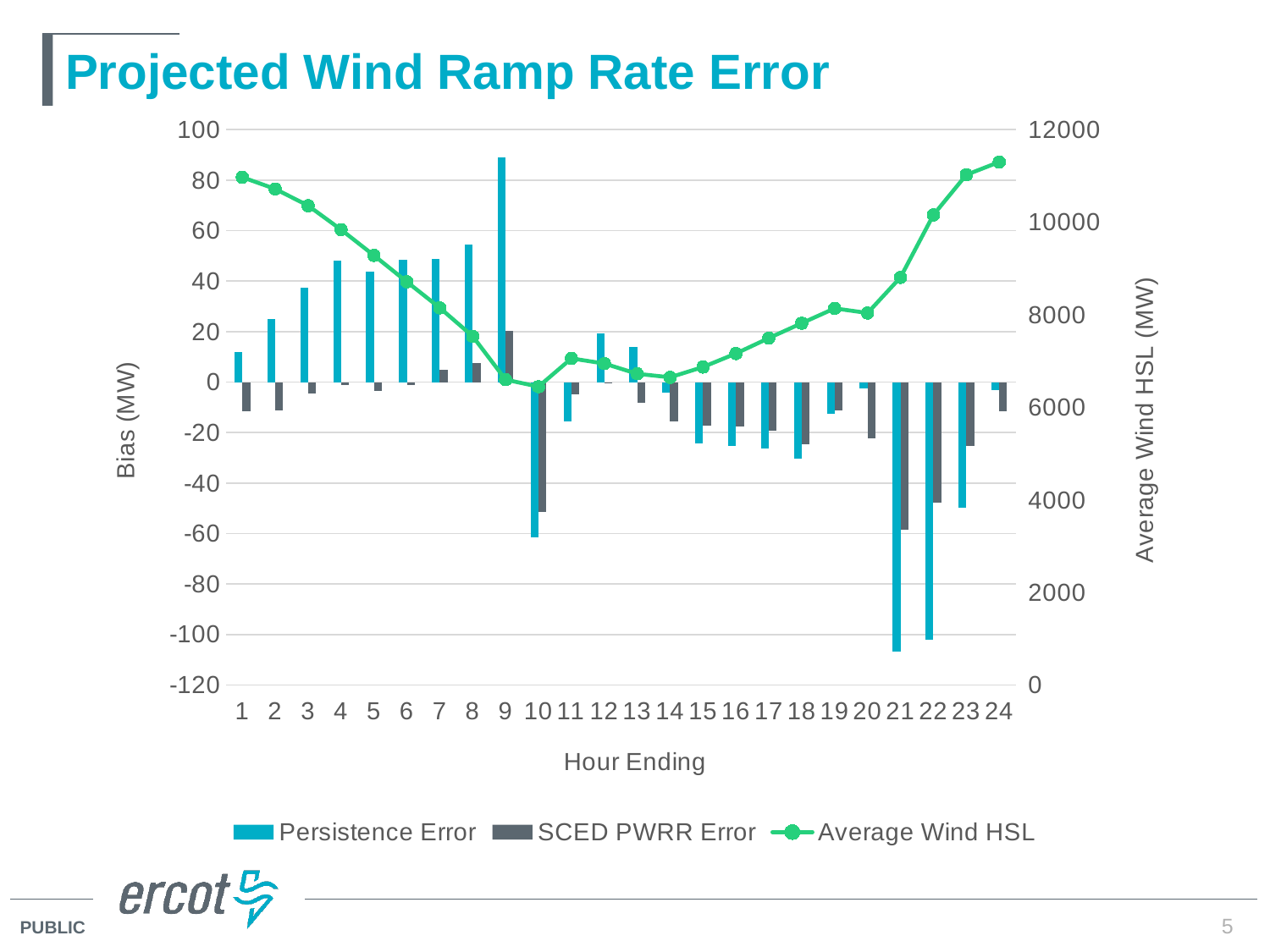
At which hour ending is the Average Wind HSL lowest? 10 Is the Persistence Error at hour ending 9 greater or less than 80? greater How many hours are plotted along the x axis? 24 At which hour ending is the Persistence Error highest? 9 How many series does the legend list? 3 Is the SCED PWRR Error at hour ending 10 greater or less than -40? less Does the Average Wind HSL rise or fall from hour ending 1 to hour ending 10? fall Is the Persistence Error at hour ending 21 greater or less than -100? less At which hour ending is the Average Wind HSL highest? 24 What kind of chart is shown on the slide? A combination bar and line chart What is the title of the right-hand vertical axis? Average Wind HSL (MW)